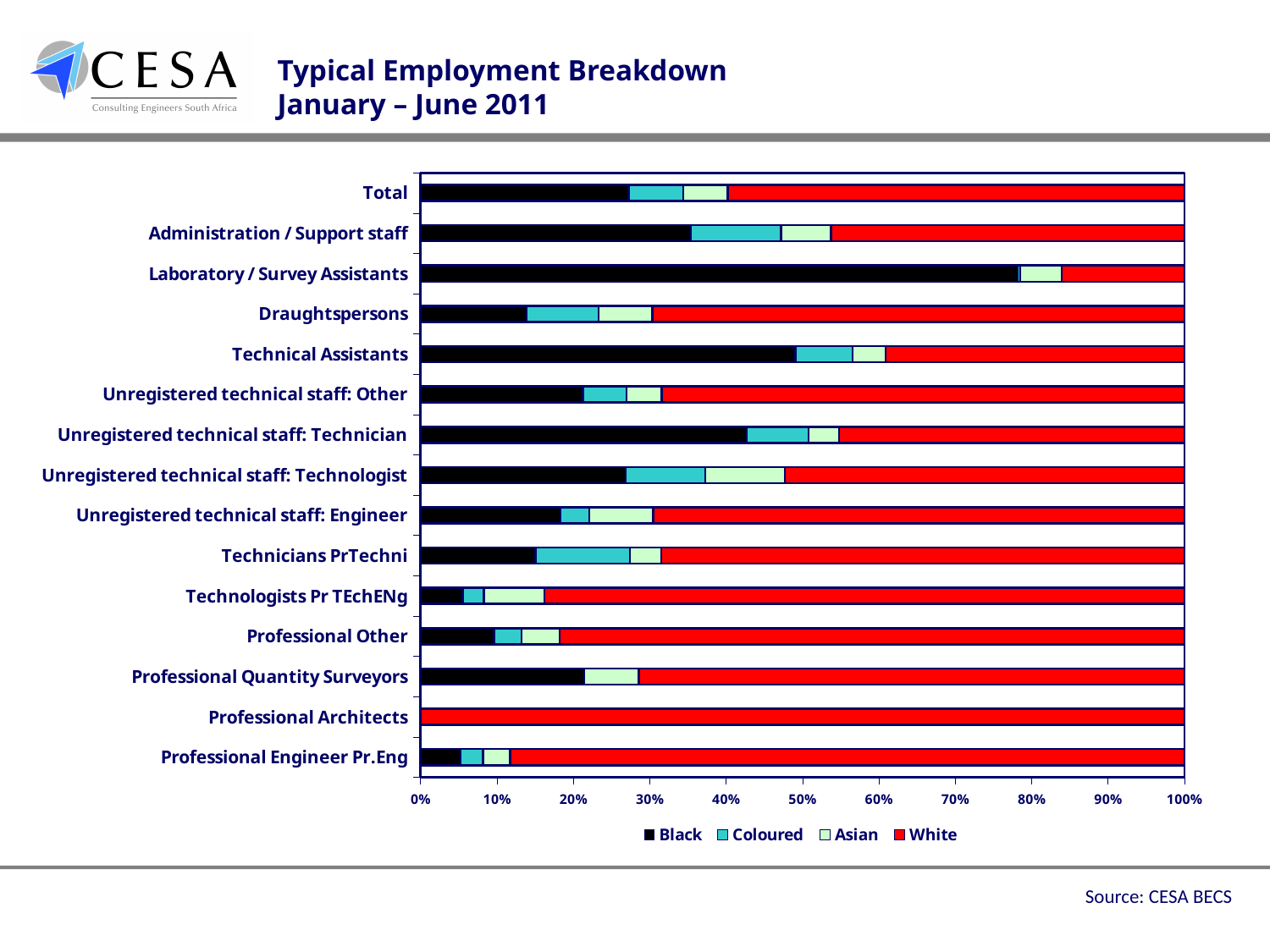
Which category has the smallest Black share? Professional Architects Is the Black share for Administration / Support staff greater or less than 30%? greater How many categories are plotted on the y axis of the chart? 15 What is the White share for Professional Architects? 100% What is the title of the chart on the slide? Typical Employment Breakdown January – June 2011 Which has the larger Black share: Administration / Support staff or Draughtspersons? Administration / Support staff How many series does the legend list? 4 Which category has the largest Black share? Laboratory / Survey Assistants Is the Black share for Laboratory / Survey Assistants greater or less than 70%? greater What are the four series listed in the legend? Black, Coloured, Asian, White Is the Black share for Professional Engineer Pr.Eng greater or less than 10%? less What kind of chart is shown on the slide? Stacked bar chart